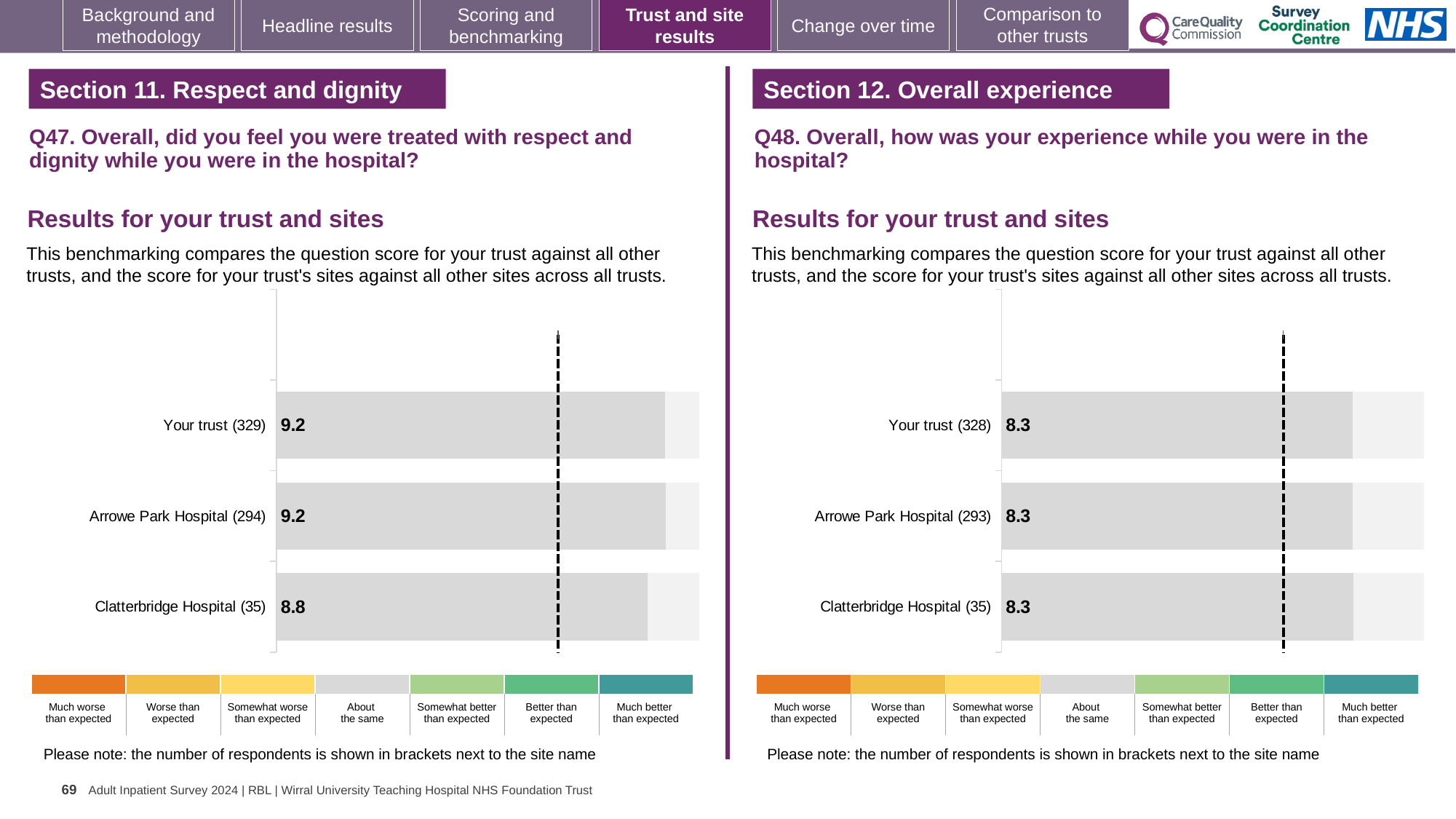
In the Q48 chart on the right, how many respondents are shown for Your trust? 328 In the Q47 chart on the left, what is the score for Clatterbridge Hospital? 8.8 In the Q47 chart on the left, which site has the lowest score? Clatterbridge Hospital In the Q47 chart on the left, what is the score for Arrowe Park Hospital? 9.2 In the Q47 chart on the left, what is the difference between the scores for Arrowe Park Hospital and Clatterbridge Hospital? 0.4 In the Q48 chart on the right, what is the score for Your trust? 8.3 In the Q47 chart on the left, which is larger: the score for Your trust or the score for Clatterbridge Hospital? Your trust In the Q48 chart on the right, what is the score for Arrowe Park Hospital? 8.3 What type of chart is used for the Q47 results on the left? Bar chart In the Q47 chart on the left, how many respondents are shown for Clatterbridge Hospital? 35 How many bars are plotted in the Q48 chart on the right? 3 In the Q47 chart on the left, what is the score for Your trust? 9.2